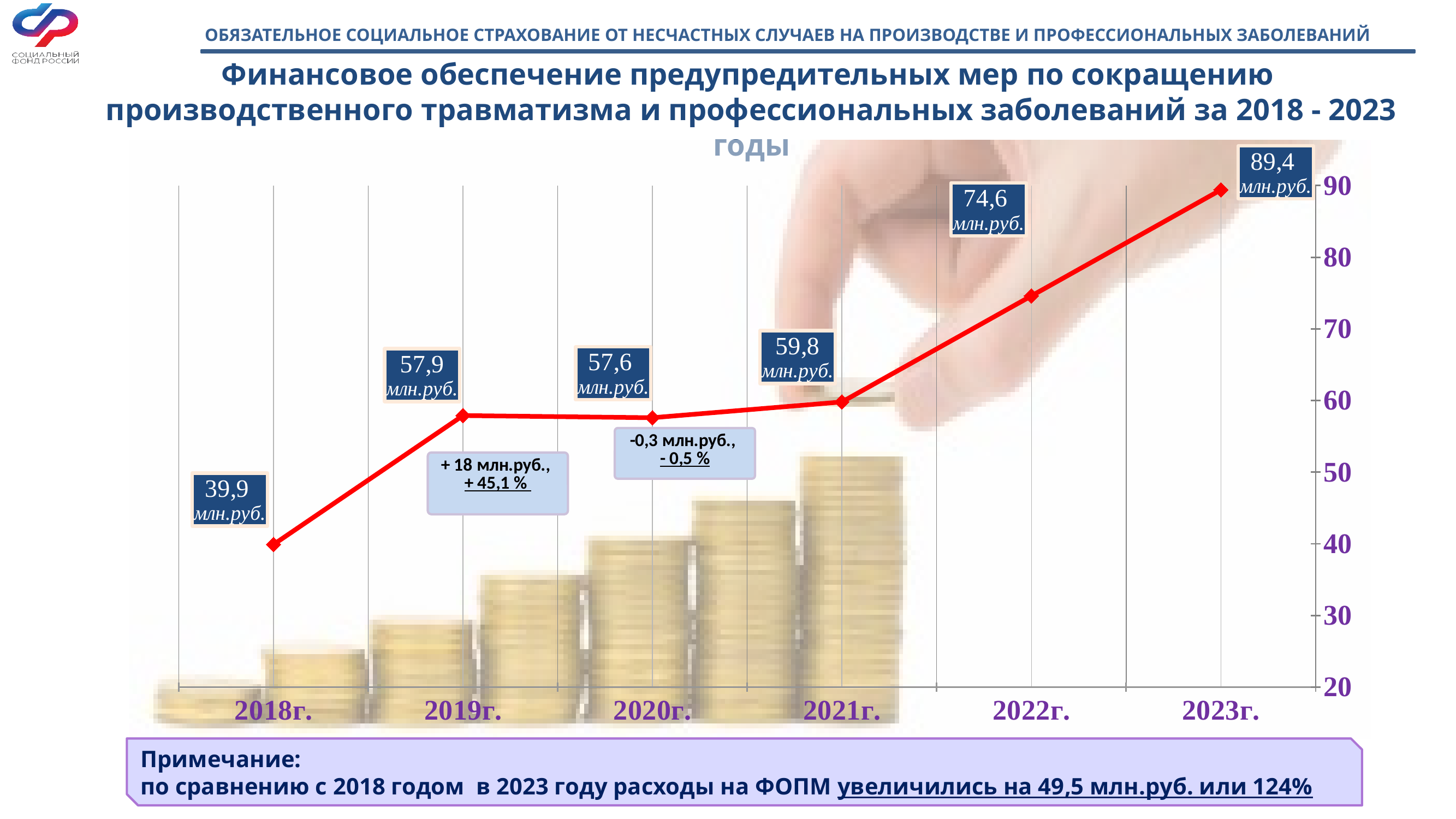
Which year has the lowest value? 2018г. What is the value for 2021г.? 59,8 млн.руб. How many years are plotted on the chart? 6 What is the value for 2018г.? 39,9 млн.руб. What kind of chart is shown on the slide? line chart What is the difference between the values for 2023г. and 2022г.? 14,8 млн.руб. What is the value for 2023г.? 89,4 млн.руб. What is the value for 2022г.? 74,6 млн.руб. Which year has the highest value? 2023г. Which is larger, the value for 2021г. or the value for 2022г.? 2022г. What is the difference between the values for 2019г. and 2018г.? 18 млн.руб. Is the value for 2022г. greater or less than 70? greater